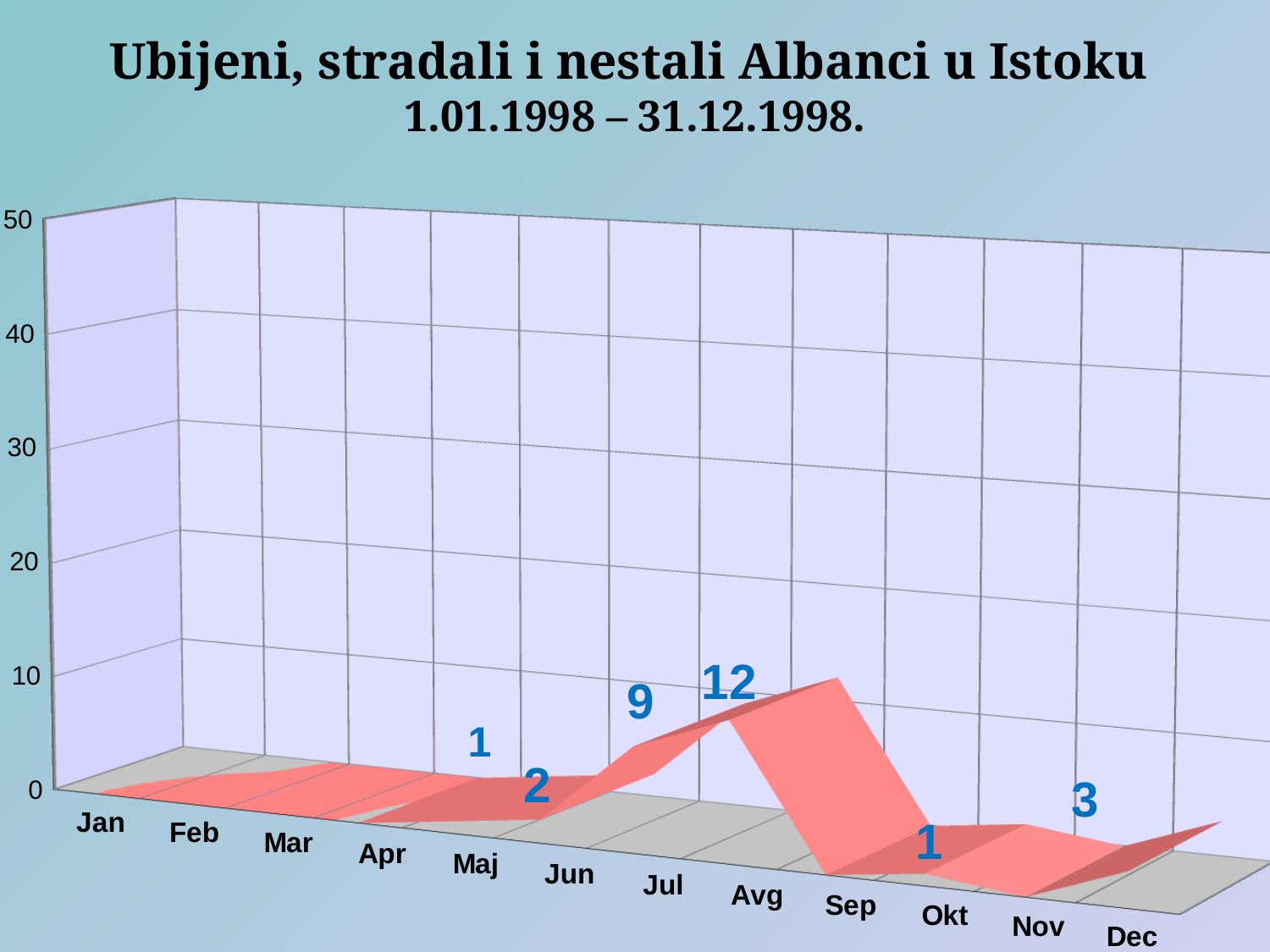
What is the title of the chart? Ubijeni, stradali i nestali Albanci u Istoku 1.01.1998 – 31.12.1998. What is the value for Avg? 12 How many months are shown on the x axis? 12 What is the value for Jul? 9 Is the value for Avg greater or less than 20? less What kind of chart is shown on the slide? 3D line chart What is the value for Jun? 2 Which month has the highest value? Avg What is the difference between the values for Avg and Jul? 3 Do the values rise or fall from Maj to Avg? rise Which is larger, the value for Jul or the value for Nov? Jul